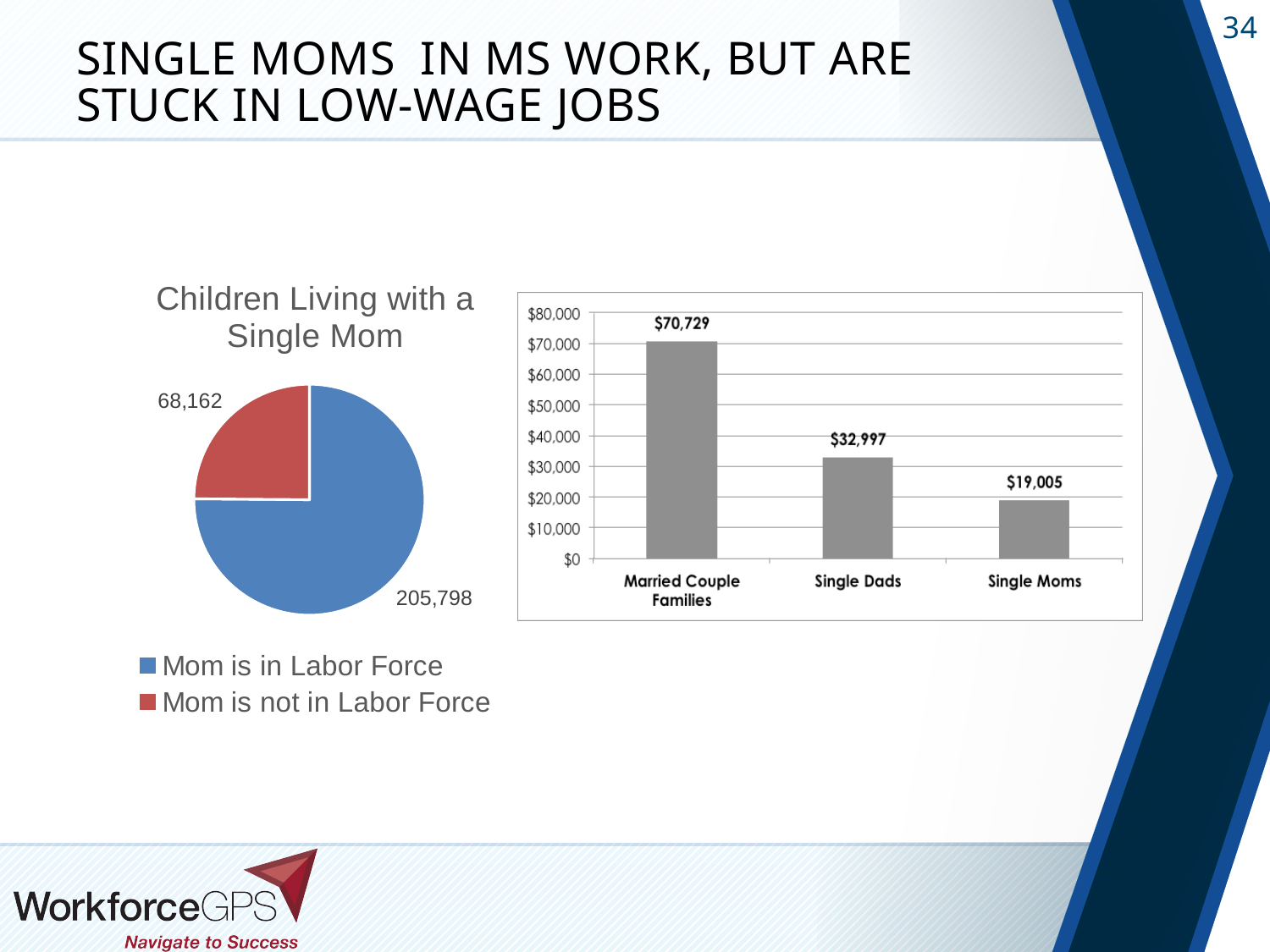
What kind of chart is the chart on the right side of the slide? Bar chart In the pie chart 'Children Living with a Single Mom', what colour is the 'Mom is not in Labor Force' slice? Red In the bar chart on the right, what is the value for Married Couple Families? $70,729 In the pie chart 'Children Living with a Single Mom', how many entries does the legend list? 2 In the pie chart 'Children Living with a Single Mom', what is the difference between the number of children whose mom is in the labor force and those whose mom is not? 137,636 In the pie chart 'Children Living with a Single Mom', how many children have a mom who is in the labor force? 205,798 In the bar chart on the right, what is the difference between the values for Single Dads and Single Moms? $13,992 In the pie chart 'Children Living with a Single Mom', how many children have a mom who is not in the labor force? 68,162 In the bar chart on the right, which category has the lowest value? Single Moms In the pie chart 'Children Living with a Single Mom', what is the total number of children across both slices? 273,960 In the bar chart on the right, what is the value for Single Moms? $19,005 In the pie chart 'Children Living with a Single Mom', which slice is larger: 'Mom is in Labor Force' or 'Mom is not in Labor Force'? Mom is in Labor Force